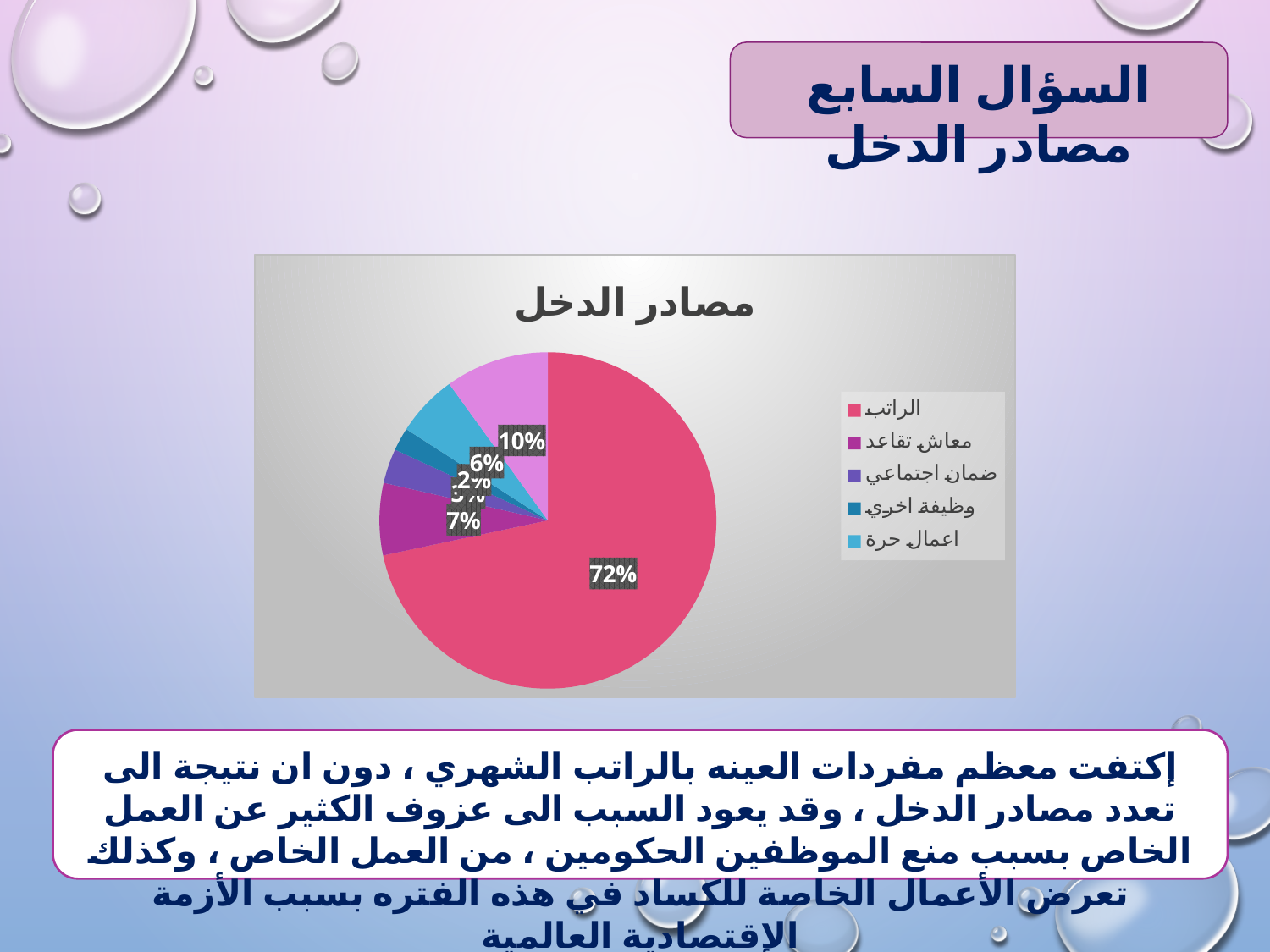
Which is larger in the pie chart: the slice for الراتب or the slice for معاش تقاعد? الراتب What percentage of the pie chart 'مصادر الدخل' is the slice for الراتب? 72% How many entries does the legend of the pie chart list? 5 What is the title of the chart on the slide? مصادر الدخل What type of chart is shown on the slide? Pie chart What percentage does the slice for اعمال حرة represent in the pie chart? 6% Which category has the largest slice in the pie chart? الراتب What share of the pie does الراتب account for? 72% What percentage does the slice for معاش تقاعد represent in the pie chart? 7% How many slices does the pie chart have? 6 By how many percentage points does the الراتب slice exceed the معاش تقاعد slice? 65 percentage points Which is larger in the pie chart: the slice for اعمال حرة or the slice for معاش تقاعد? معاش تقاعد